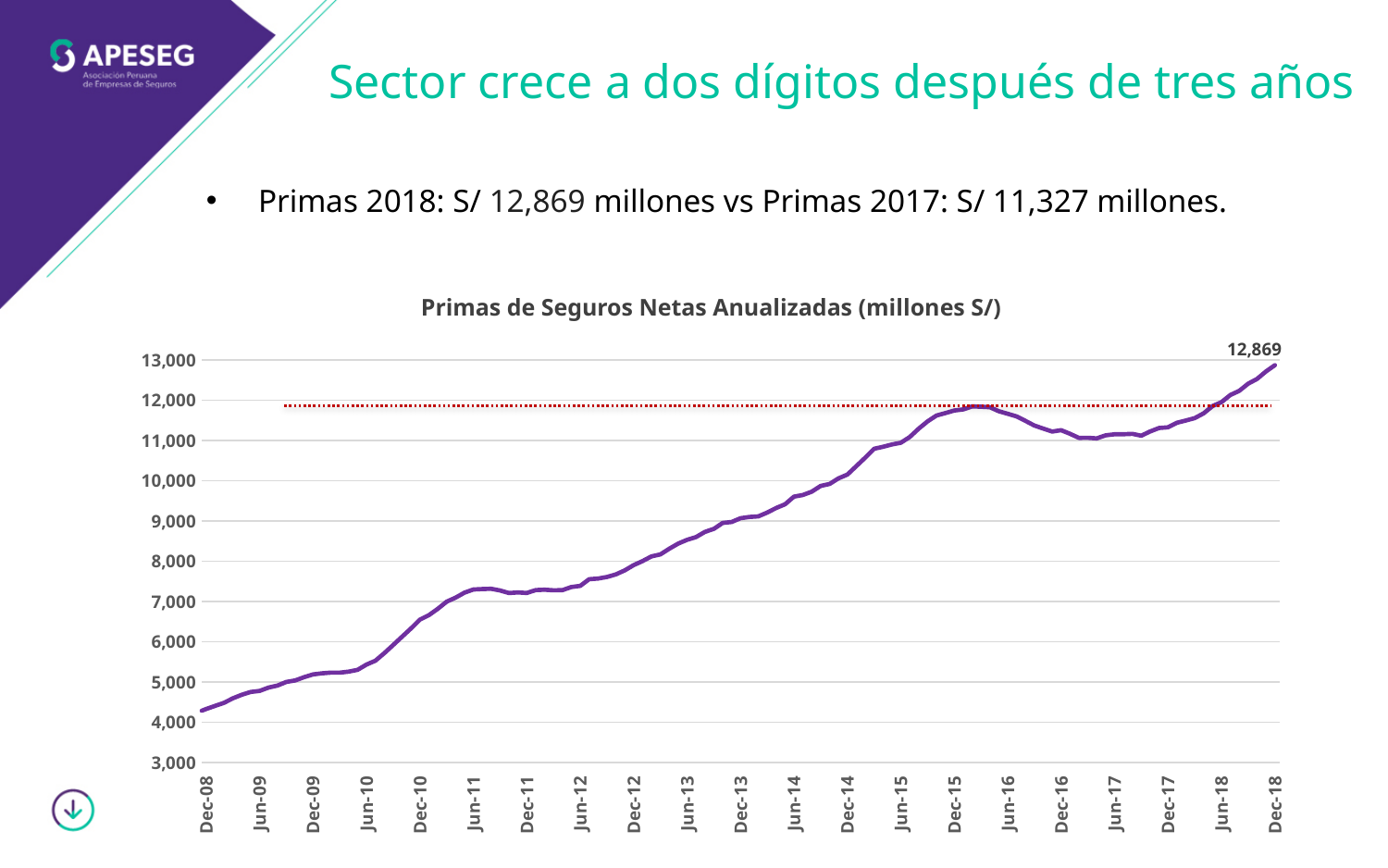
Is the value for Dec-10 greater or less than 7,000? less What is the title of the chart? Primas de Seguros Netas Anualizadas (millones S/) Which is larger, the value for Dec-15 or the value for Dec-16? Dec-15 How many labels are shown on the x axis? 21 What is the value shown for Dec-18 on the chart? 12,869 Which x-axis point has the highest value? Dec-18 What kind of chart is shown on the slide? line chart Is the value for Jun-14 greater or less than 9,000? greater Do the values generally rise or fall from Dec-08 to Dec-18? rise Is the value for Dec-15 greater or less than 11,000? greater Which x-axis point has the lowest value? Dec-08